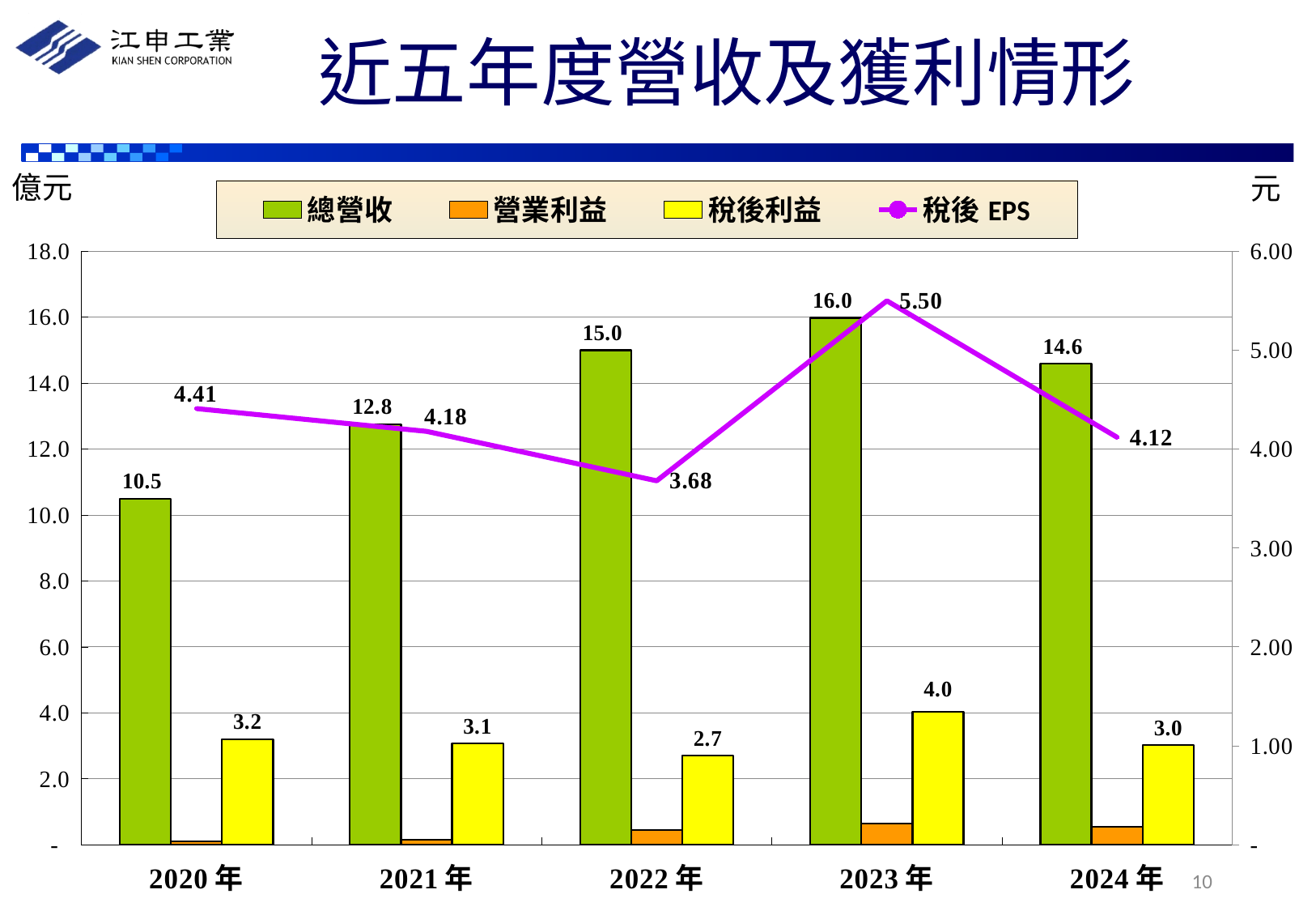
Which year has the highest 總營收? 2023 年 Which year has the lowest 稅後 EPS? 2022 年 Is the 營業利益 value for 2023 年 greater or less than 2.0? less Does the 總營收 rise or fall from 2020 年 to 2023 年? rise How many series does the legend list? 4 What kind of chart is this? Combined bar and line chart What is the difference between the 總營收 for 2023 年 and 2024 年? 1.4 How many years are shown on the x axis? 5 What is the 稅後 EPS value for 2022 年? 3.68 Which is larger, the 稅後利益 for 2020 年 or for 2021 年? 2020 年 What is the 稅後利益 value for 2024 年? 3.0 What is the 總營收 value for 2023 年? 16.0